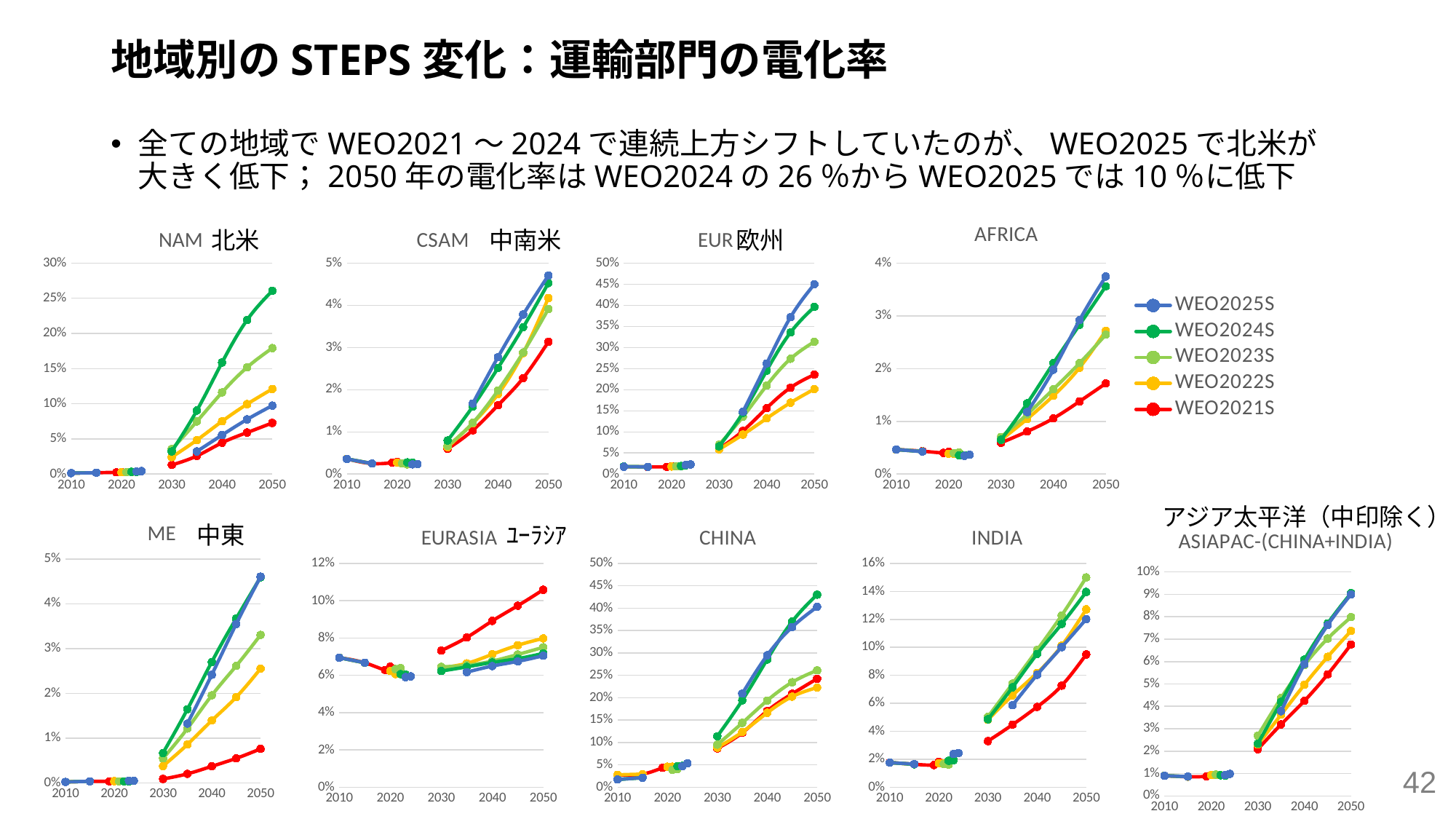
In the NAM 北米 chart, which series has the highest value in 2050? WEO2024S In the ME 中東 chart, does the WEO2024S series rise or fall from 2030 to 2050? rise What kind of chart is the NAM 北米 chart? line chart In the EUR 欧州 chart, is the WEO2025S value in 2050 greater or less than 40%? greater In the EURASIA ユーラシア chart, which series has the highest value in 2050? WEO2021S In the NAM 北米 chart, which series has the lowest value in 2050? WEO2021S How many series does the legend list? 5 How many charts are shown on the slide? 9 In the INDIA chart, is the WEO2021S value in 2050 greater or less than 10%? less In the NAM 北米 chart, is the WEO2025S value in 2050 greater or less than 15%? less In the CHINA chart, which series has the highest value in 2050? WEO2024S In the NAM 北米 chart, which is larger in 2050, WEO2024S or WEO2025S? WEO2024S